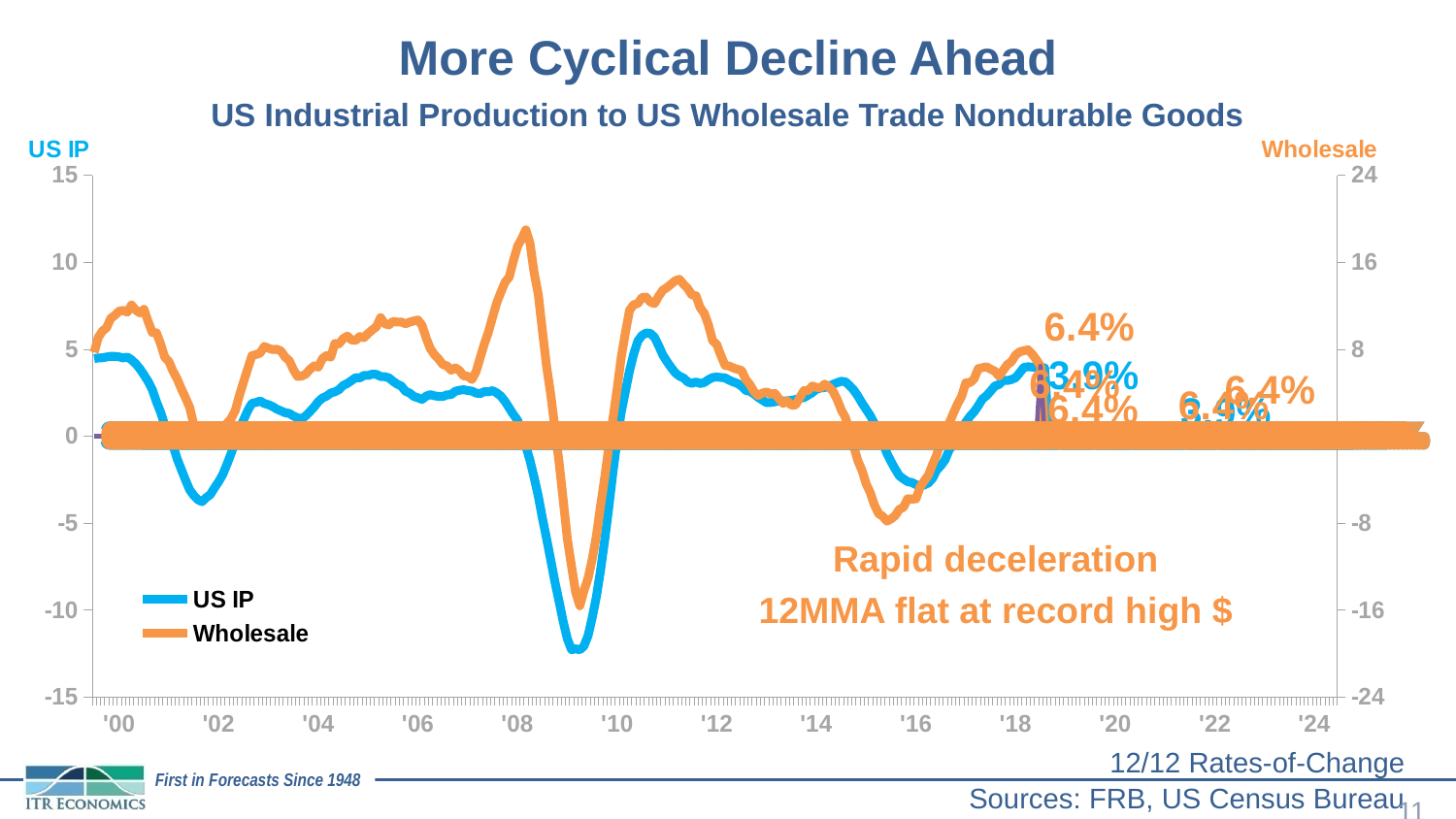
What kind of chart is shown on the slide? line chart How many year labels are shown along the x axis? 13 Around which year does the US IP line reach its lowest point? '09 Is the value of the Wholesale line at its peak around '08 greater or less than 8 on the right axis? greater What is the title printed above the chart? US Industrial Production to US Wholesale Trade Nondurable Goods Is the value of the Wholesale line at its trough around '09 greater or less than -8 on the right axis? less Around which year does the Wholesale line reach its highest point? '08 Does the US IP line rise or fall between '08 and '09? fall Is the value of the US IP line at its trough around '01-'02 greater or less than 0? less How many series does the legend list? 2 What are the two series named in the legend? US IP and Wholesale